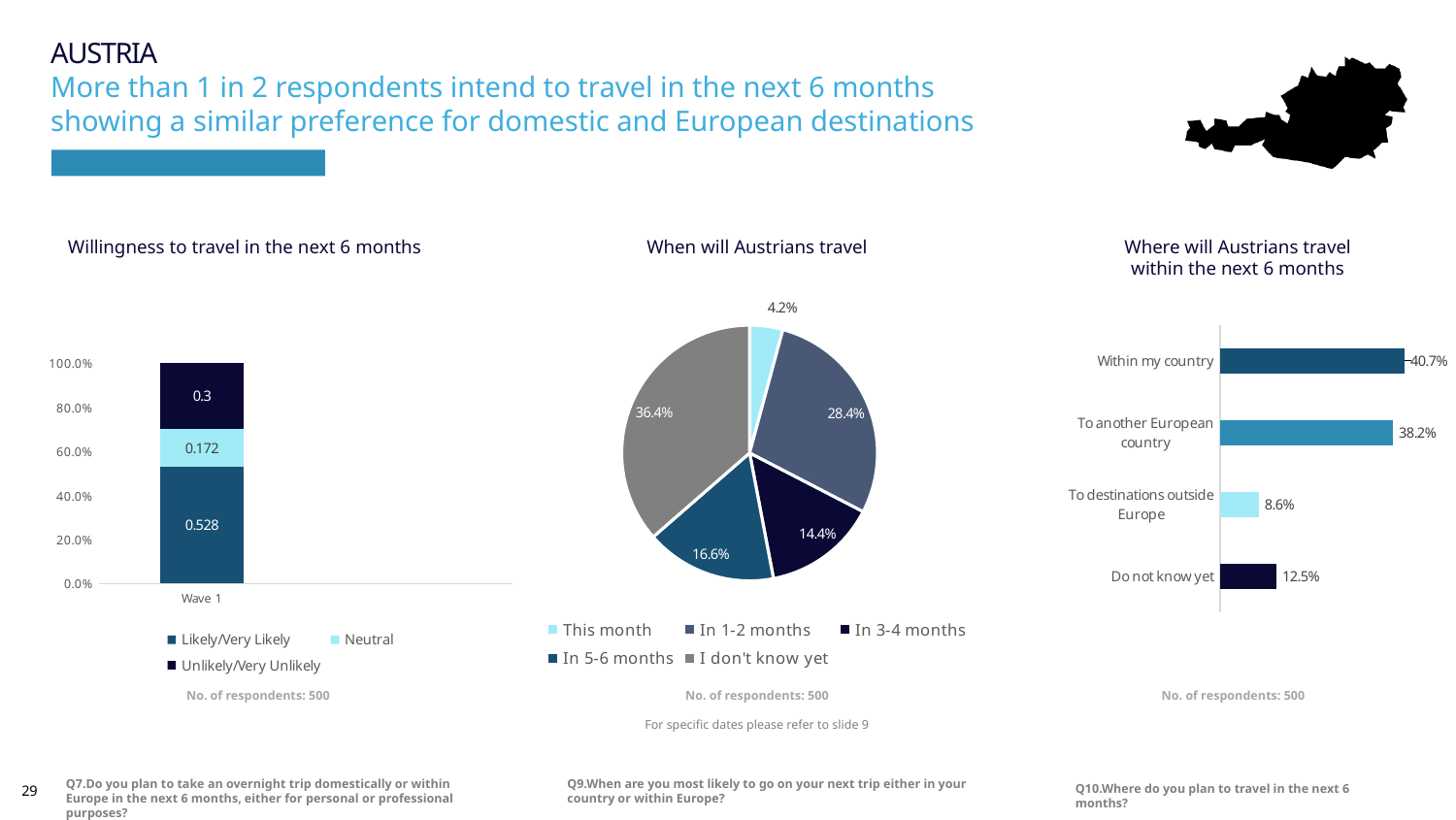
In the 'Willingness to travel in the next 6 months' chart, how many series does the legend list? 3 In the 'When will Austrians travel' chart, what is the difference between 'In 5-6 months' and 'In 3-4 months'? 2.2% In the 'When will Austrians travel' chart, what kind of chart is shown? Pie chart In the 'Willingness to travel in the next 6 months' chart, what is the value for Likely/Very Likely in Wave 1? 0.528 In the 'Where will Austrians travel within the next 6 months' chart, which category has the lowest value? To destinations outside Europe In the 'Willingness to travel in the next 6 months' chart, what is the total of the stacked bar for Wave 1? 1.0 In the 'Where will Austrians travel within the next 6 months' chart, which is larger: 'Do not know yet' or 'To destinations outside Europe'? Do not know yet In the 'Willingness to travel in the next 6 months' chart, what is the value for Neutral? 0.172 In the 'When will Austrians travel' chart, which category has the largest slice? I don't know yet In the 'When will Austrians travel' chart, which category has the smallest slice? This month In the 'Where will Austrians travel within the next 6 months' chart, what is the value for 'To another European country'? 38.2% In the 'When will Austrians travel' chart, what share of respondents said 'In 1-2 months'? 28.4%